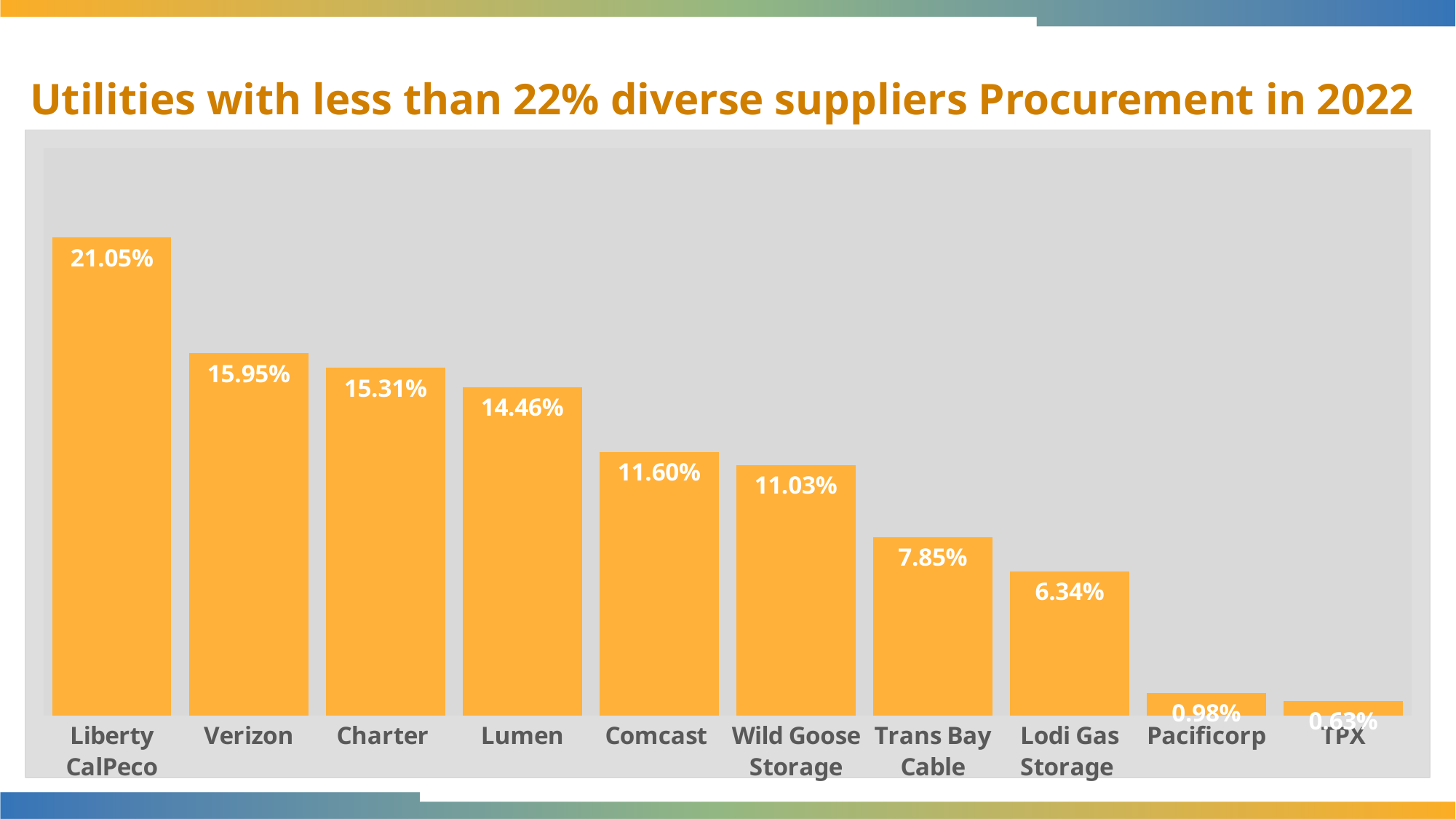
What kind of chart is this? Bar chart What is the value for Wild Goose Storage? 11.03% Do the values rise or fall from left to right along the x axis? Fall How many utilities are shown in the chart? 10 What is the difference between the values for Comcast and Wild Goose Storage? 0.57% Which has a larger value, Charter or Lumen? Charter What is the difference between the values for Liberty CalPeco and Verizon? 5.10% Which utility has the highest value? Liberty CalPeco What is the value for Lodi Gas Storage? 6.34% Which has a larger value, Trans Bay Cable or Lodi Gas Storage? Trans Bay Cable What is the value for Verizon? 15.95% Which utility has the lowest value? TPX